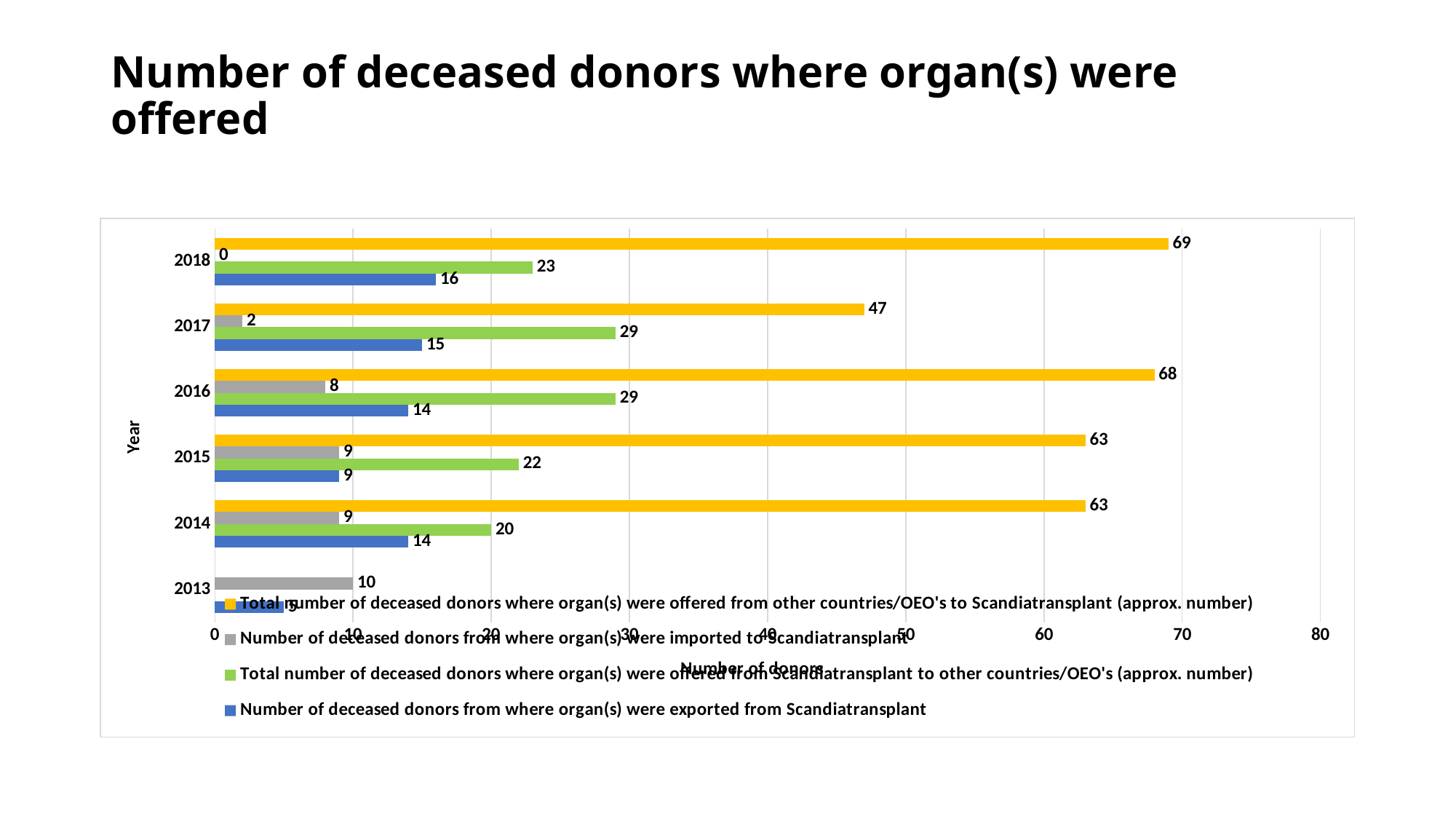
Is the 2017 value for 'Total number of deceased donors where organ(s) were offered from other countries/OEO's to Scandiatransplant (approx. number)' greater or less than 50? less What is the value for 2016 in the series 'Number of deceased donors from where organ(s) were exported from Scandiatransplant'? 14 What kind of chart is shown on the slide? bar chart What is the value for 2017 in the series 'Total number of deceased donors where organ(s) were offered from Scandiatransplant to other countries/OEO's (approx. number)'? 29 What is the value for 2013 in the series 'Number of deceased donors from where organ(s) were imported to Scandiatransplant'? 10 How many series does the legend list? 4 Which year has the highest value for 'Total number of deceased donors where organ(s) were offered from other countries/OEO's to Scandiatransplant (approx. number)'? 2018 What is the value for 2018 in the series 'Total number of deceased donors where organ(s) were offered from other countries/OEO's to Scandiatransplant (approx. number)'? 69 Which year has the lowest value for 'Number of deceased donors from where organ(s) were imported to Scandiatransplant'? 2018 How many years are shown on the chart? 6 Which year has the larger value for 'Total number of deceased donors where organ(s) were offered from Scandiatransplant to other countries/OEO's (approx. number)': 2015 or 2014? 2015 For 2018, what is the difference between the number of donors where organs were offered from other countries/OEO's to Scandiatransplant and the number of donors from where organs were exported from Scandiatransplant? 53